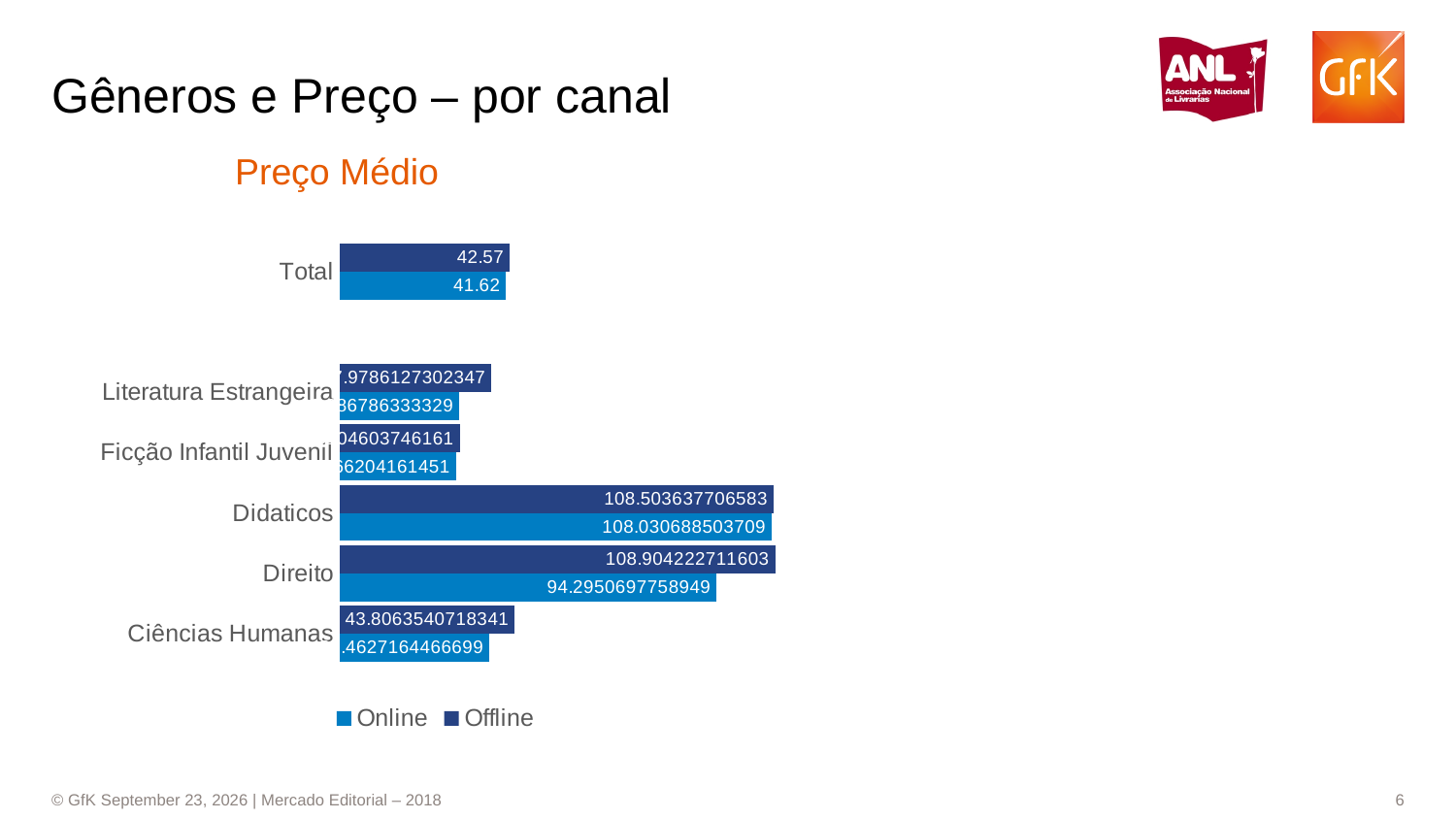
How many series does the legend list? 2 What is the difference between the Offline and Online values for Total? 0.95 What is the Online value for Total? 41.62 What is the Online value for Direito? 94.2950697758949 What is the Online value for Didaticos? 108.030688503709 What are the two series named in the legend? Online and Offline What kind of chart is shown on the slide? bar chart For Direito, which is larger, the Online value or the Offline value? Offline What is the Offline value for Didaticos? 108.503637706583 What is the title of the chart? Preço Médio What is the Offline value for Total? 42.57 How many categories are shown on the chart? 6